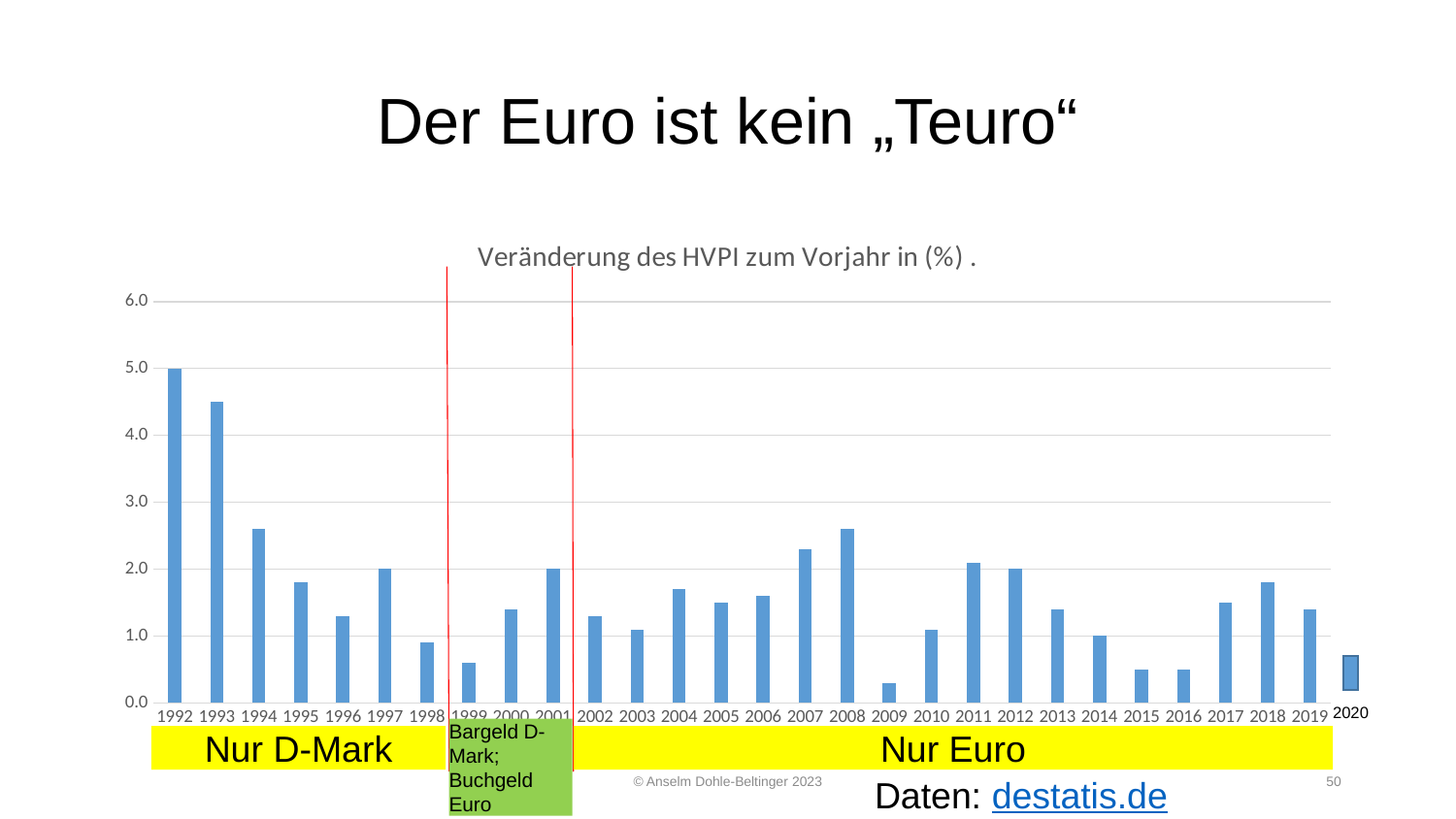
Is the value for 1993 greater or less than 4.0? greater What is the title of the chart? Veränderung des HVPI zum Vorjahr in (%) . What is the value for 1992? 5.0 Is the value for 2008 greater or less than 3.0? less Which is larger, the value for 1993 or the value for 2011? 1993 How many years (bars) are shown in the chart? 28 What kind of chart is shown on the slide? bar chart Which year has the lowest value in the chart? 2009 Do the values rise or fall from 1992 to 1998? fall Is the value for 2015 greater or less than 1.0? less Which year has the highest value in the chart? 1992 What is the value for 2014? 1.0